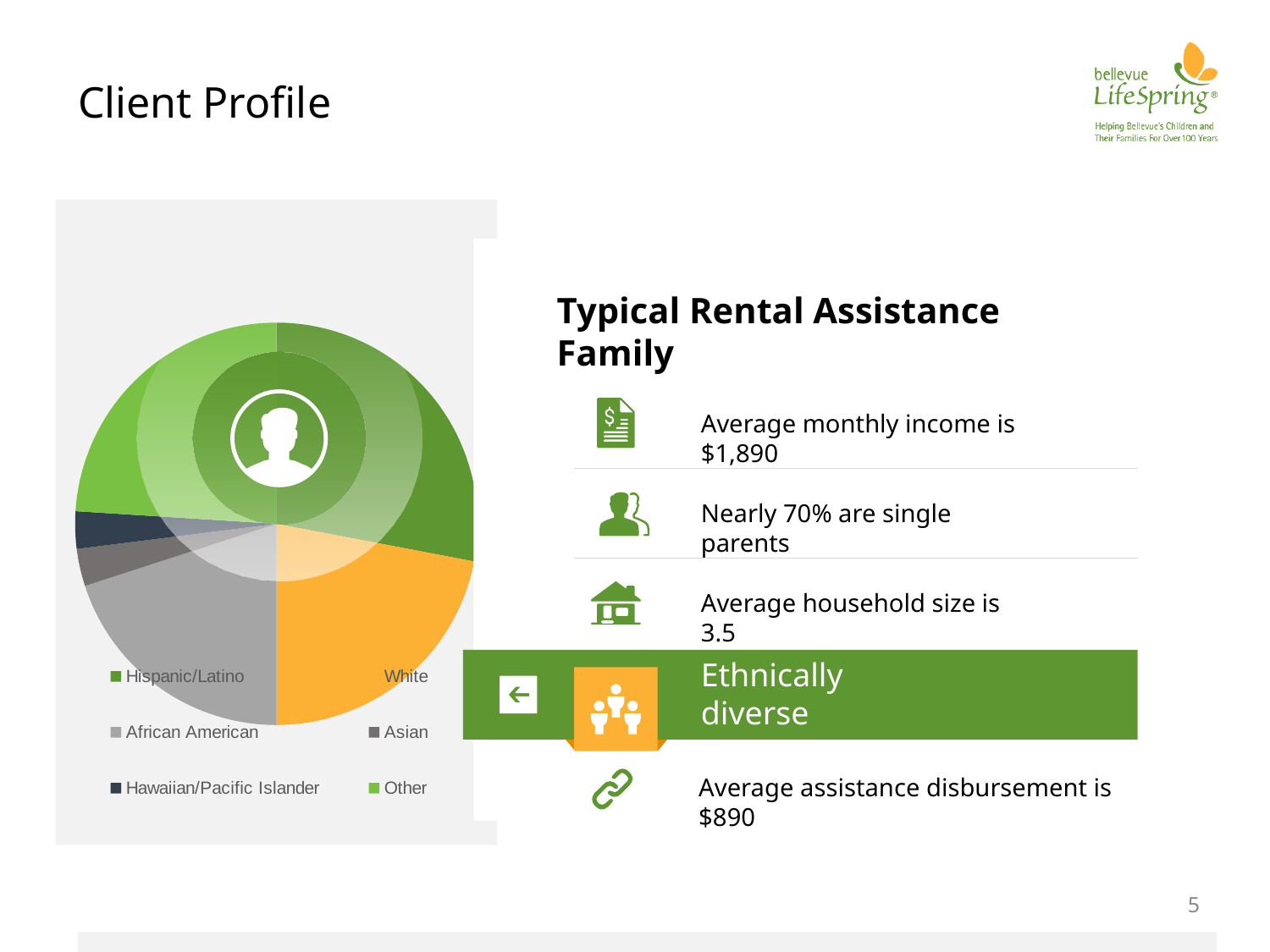
What colour is the White slice in the pie chart? orange How many categories does the pie chart's legend list? 6 Which slice is larger in the pie chart, Hispanic/Latino or White? Hispanic/Latino Which slice is larger in the pie chart, African American or Other? Other Which slice is larger in the pie chart, African American or Hawaiian/Pacific Islander? African American What kind of chart is shown on the slide? pie chart Which category has the largest slice in the pie chart? Hispanic/Latino Which legend entry in the pie chart is shown in dark navy blue? Hawaiian/Pacific Islander